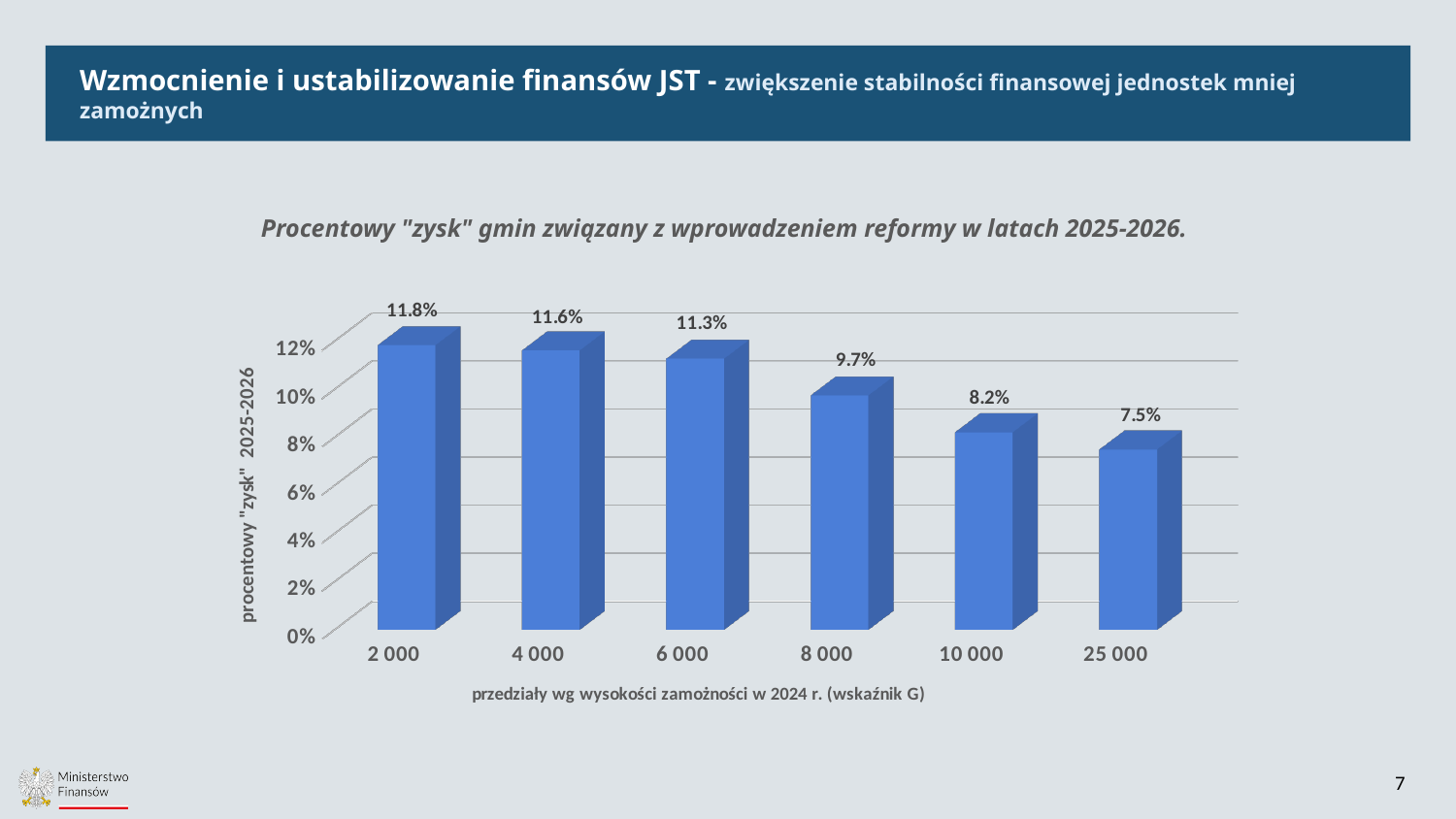
What is the difference between the values for 6 000 and 8 000? 1.6% Do the values rise or fall from left to right along the x axis? fall Which category has the lowest value? 25 000 What kind of chart is shown on the slide? bar chart What is the difference between the values for 2 000 and 25 000? 4.3% Which category has the highest value? 2 000 What is the value for the 2 000 category? 11.8% How many categories are shown on the x axis? 6 What is the value for the 8 000 category? 9.7% What is the value for the 25 000 category? 7.5% Is the value for 10 000 greater or less than 10%? less Which is larger, the value for 4 000 or the value for 10 000? 4 000